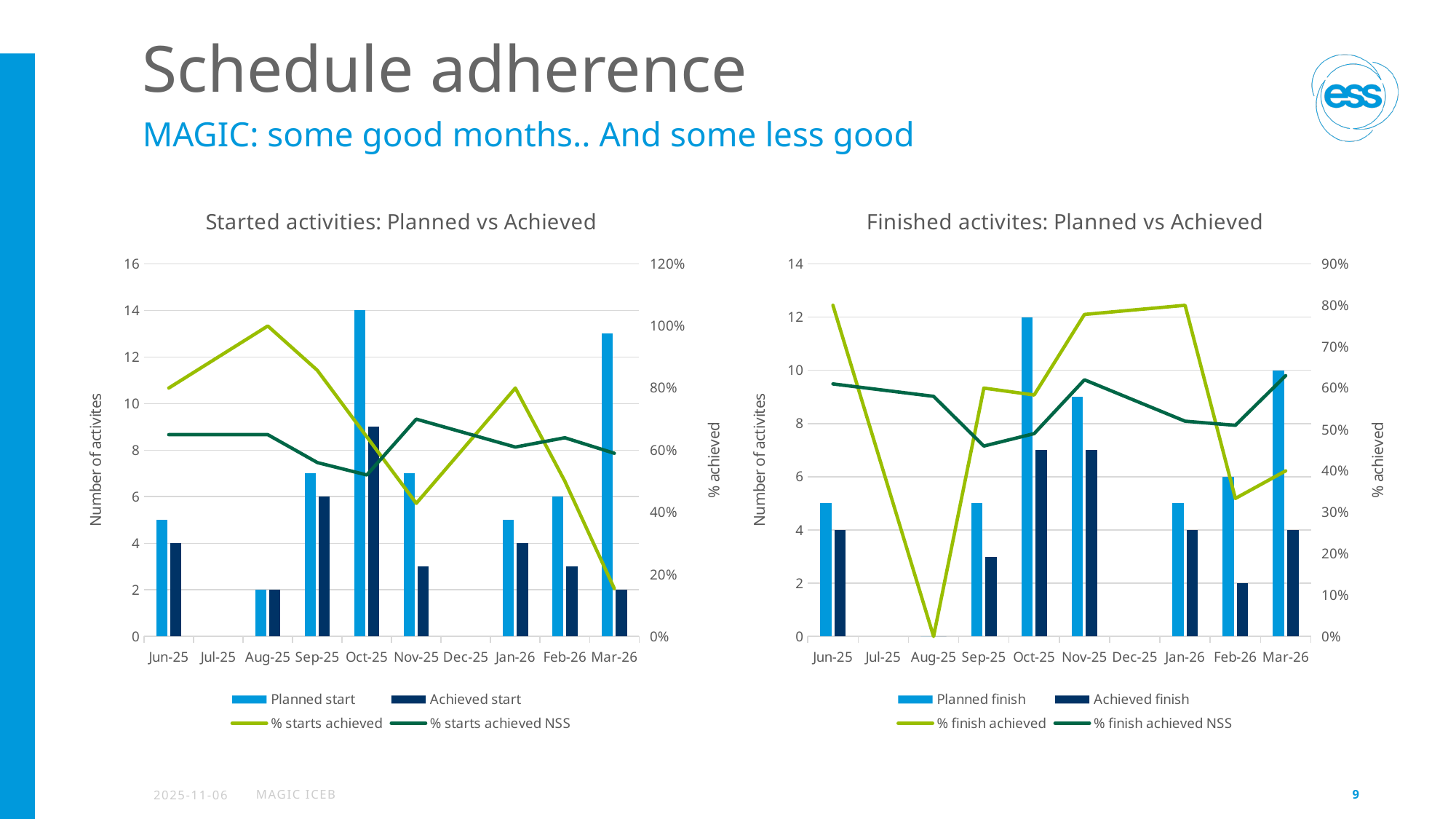
In the 'Started activities: Planned vs Achieved' chart, is the Planned start value for Mar-26 greater or less than 12? greater In the 'Started activities: Planned vs Achieved' chart, what is the Planned start value for Oct-25? 14 In the 'Started activities: Planned vs Achieved' chart, does the % starts achieved line rise or fall from Jan-26 to Mar-26? Fall In the 'Started activities: Planned vs Achieved' chart, what is the Achieved start value for Sep-25? 6 In the 'Started activities: Planned vs Achieved' chart, which is larger: the Achieved start for Oct-25 or for Nov-25? Oct-25 In the 'Finished activites: Planned vs Achieved' chart, which month has the lowest % finish achieved value? Aug-25 In the 'Started activities: Planned vs Achieved' chart, which month has the highest Planned start value? Oct-25 In the 'Started activities: Planned vs Achieved' chart, what is the difference between the Planned start values for Oct-25 and Feb-26? 8 In the 'Finished activites: Planned vs Achieved' chart, what is the % finish achieved value for Aug-25? 0% How many series does the legend of the 'Finished activites: Planned vs Achieved' chart list? 4 In the 'Finished activites: Planned vs Achieved' chart, what is the Planned finish value for Oct-25? 12 What kind of chart is the 'Started activities: Planned vs Achieved' chart? Combined bar and line chart